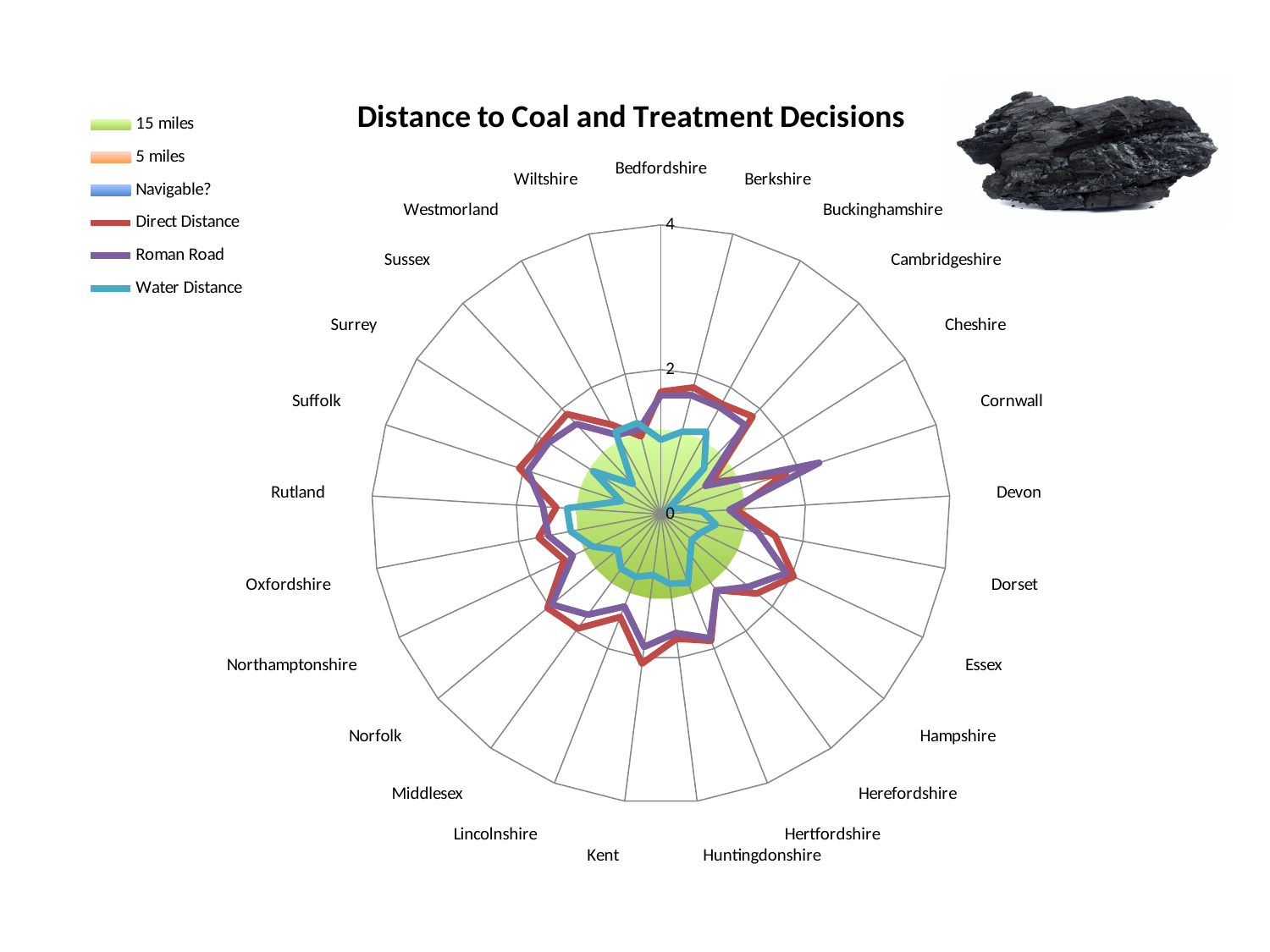
What kind of chart is shown on the slide? Radar chart For Kent, which is larger: the Direct Distance value or the Water Distance value? Direct Distance Is the Water Distance value for Bedfordshire greater or less than 2? less Which colour is used for the Direct Distance series? Red For Dorset, which is larger: the Roman Road value or the Water Distance value? Roman Road For Bedfordshire, which is larger: the Direct Distance value or the Water Distance value? Direct Distance How many counties are plotted around the radar chart? 25 Is the Water Distance value for Rutland greater or less than 2? less Is the Water Distance value for Devon greater or less than 2? less What is the highest value labelled on the radial axis? 4 What is the title of the chart? Distance to Coal and Treatment Decisions How many series does the legend list? 6